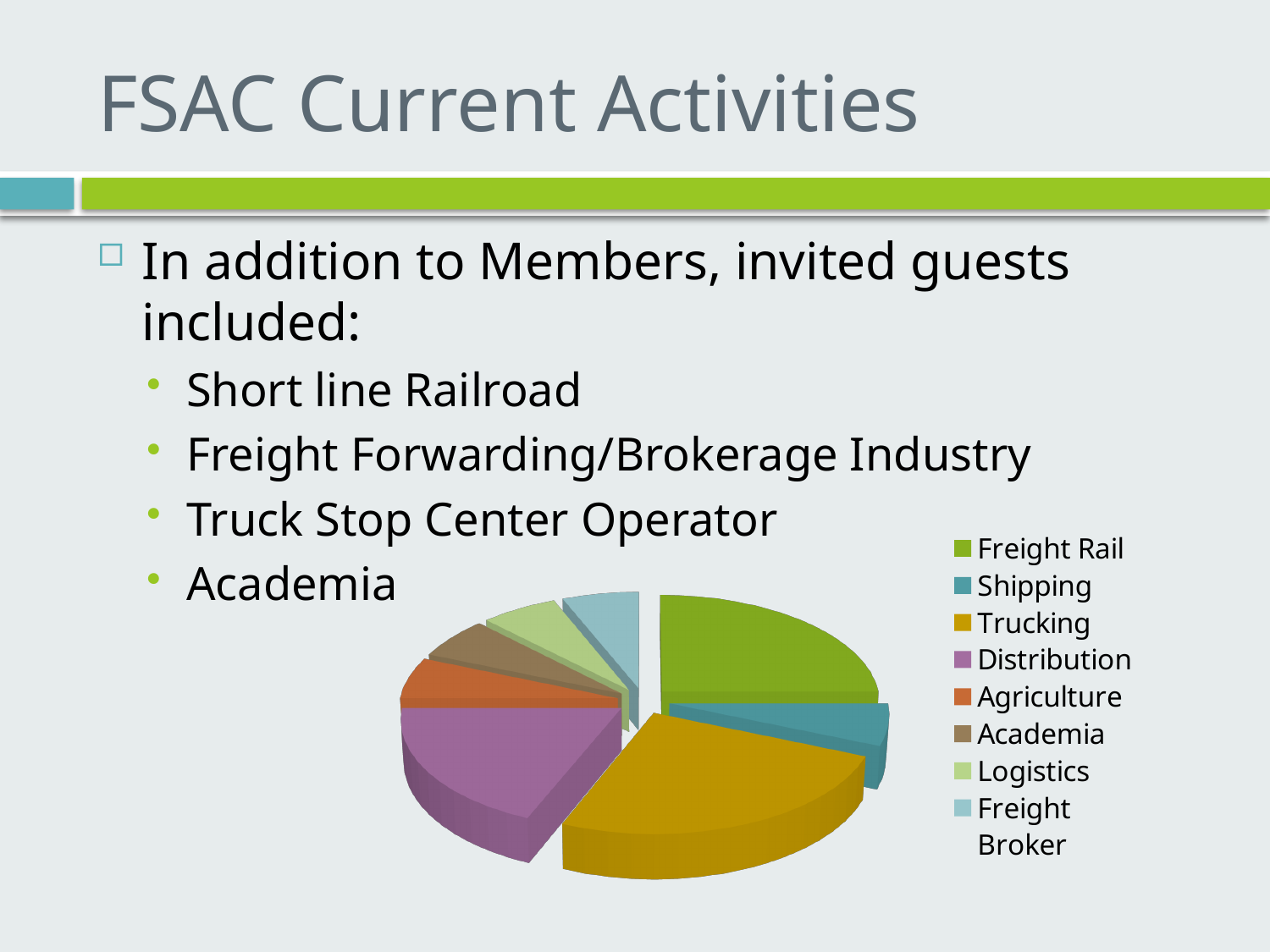
What kind of chart is shown on the slide? pie chart How many categories does the pie chart's legend list? 8 Which slice is larger in the pie chart, Distribution or Agriculture? Distribution Which category is listed first in the pie chart's legend? Freight Rail Which slice is larger in the pie chart, Distribution or Logistics? Distribution What colour is the Distribution slice in the pie chart? purple Which slice is larger in the pie chart, Trucking or Shipping? Trucking